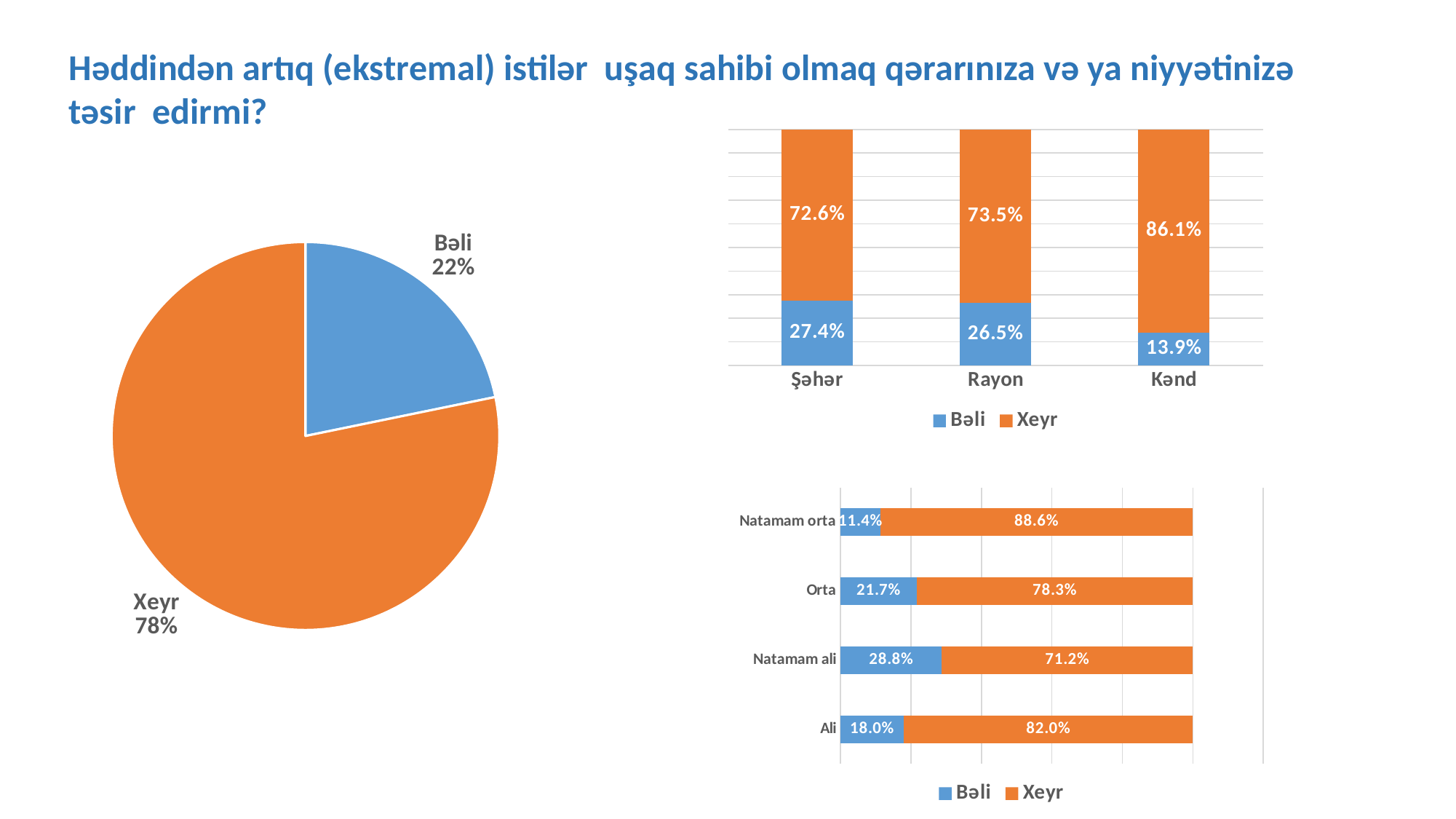
In the bottom-right bar chart, what is the Bəli value for Natamam ali? 28.8% In the top-right bar chart, what is the difference between the Xeyr values for Kənd and Rayon? 12.6% In the top-right bar chart, what is the Bəli value for Şəhər? 27.4% In the pie chart on the left, what share is labelled Xeyr? 78% In the bottom-right bar chart, which category has the highest Xeyr value? Natamam orta In the pie chart on the left, what share is labelled Bəli? 22% In the top-right bar chart, what is the Xeyr value for Kənd? 86.1% In the bottom-right bar chart, is the Bəli value for Orta larger or smaller than the Bəli value for Ali? larger In the top-right bar chart, which category has the lowest Bəli value? Kənd How many series does the legend of the bottom-right bar chart list? 2 How many categories are shown on the x axis of the top-right bar chart? 3 What kind of chart is the chart on the left of the slide? pie chart